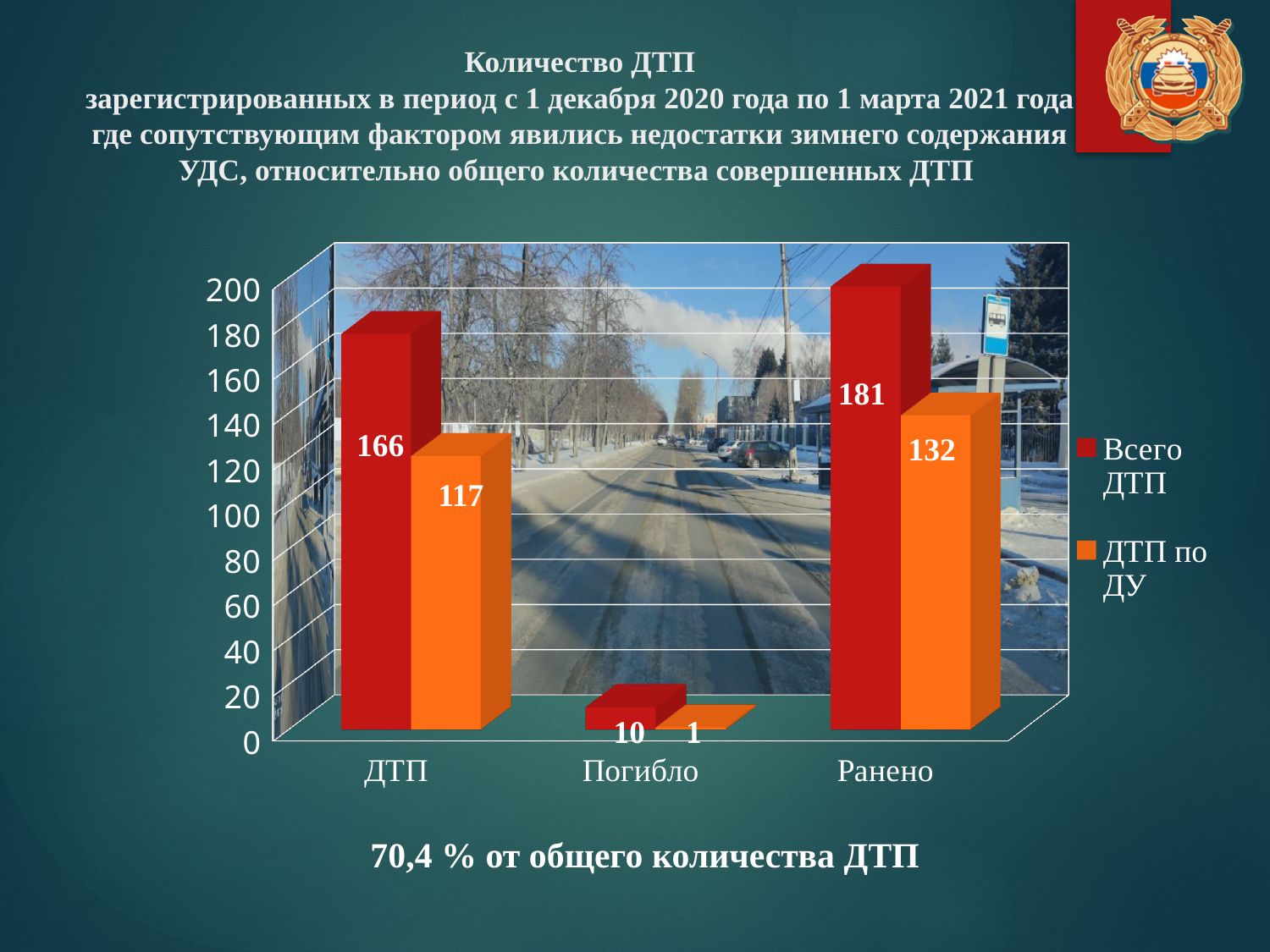
How many categories are shown on the x axis of the chart? 3 Which category has the highest value in the "Всего ДТП" series? Ранено How many series does the legend list? 2 What is the value of "Всего ДТП" for the category "Погибло"? 10 What is the difference between "Всего ДТП" and "ДТП по ДУ" for the category "ДТП"? 49 What is the difference between "Всего ДТП" and "ДТП по ДУ" for the category "Ранено"? 49 Which category has the lowest value in the "ДТП по ДУ" series? Погибло What is the value of "ДТП по ДУ" for the category "Ранено"? 132 What kind of chart is shown on the slide? Bar chart What is the value of "ДТП по ДУ" for the category "Погибло"? 1 What is the value of "Всего ДТП" for the category "ДТП"? 166 Which is larger: "ДТП по ДУ" for "Ранено" or "Всего ДТП" for "ДТП"? Всего ДТП for ДТП